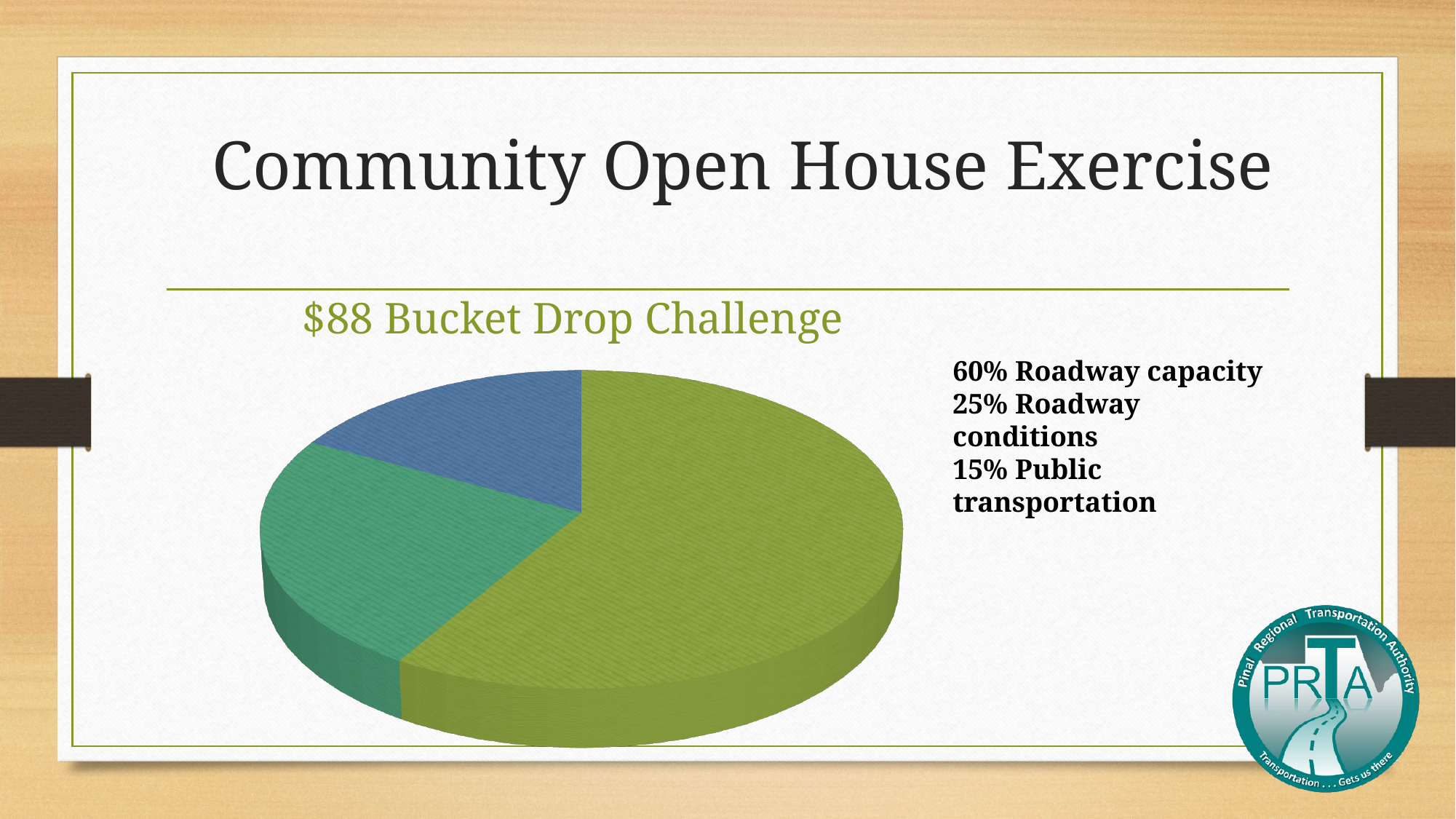
What is the title of the pie chart? $88 Bucket Drop Challenge What share of the pie is Public transportation? 15% What is the difference in percentage points between Roadway capacity and Roadway conditions? 35 What colour is the largest slice of the pie chart? green What share of the pie is Roadway capacity? 60% What share of the pie is Roadway conditions? 25% What kind of chart is shown on the slide? pie chart Which category has the smallest share of the pie? Public transportation What is the difference in percentage points between Roadway conditions and Public transportation? 10 Which is larger, the share for Roadway conditions or the share for Public transportation? Roadway conditions How many slices does the pie chart have? 3 Which category has the largest share of the pie? Roadway capacity